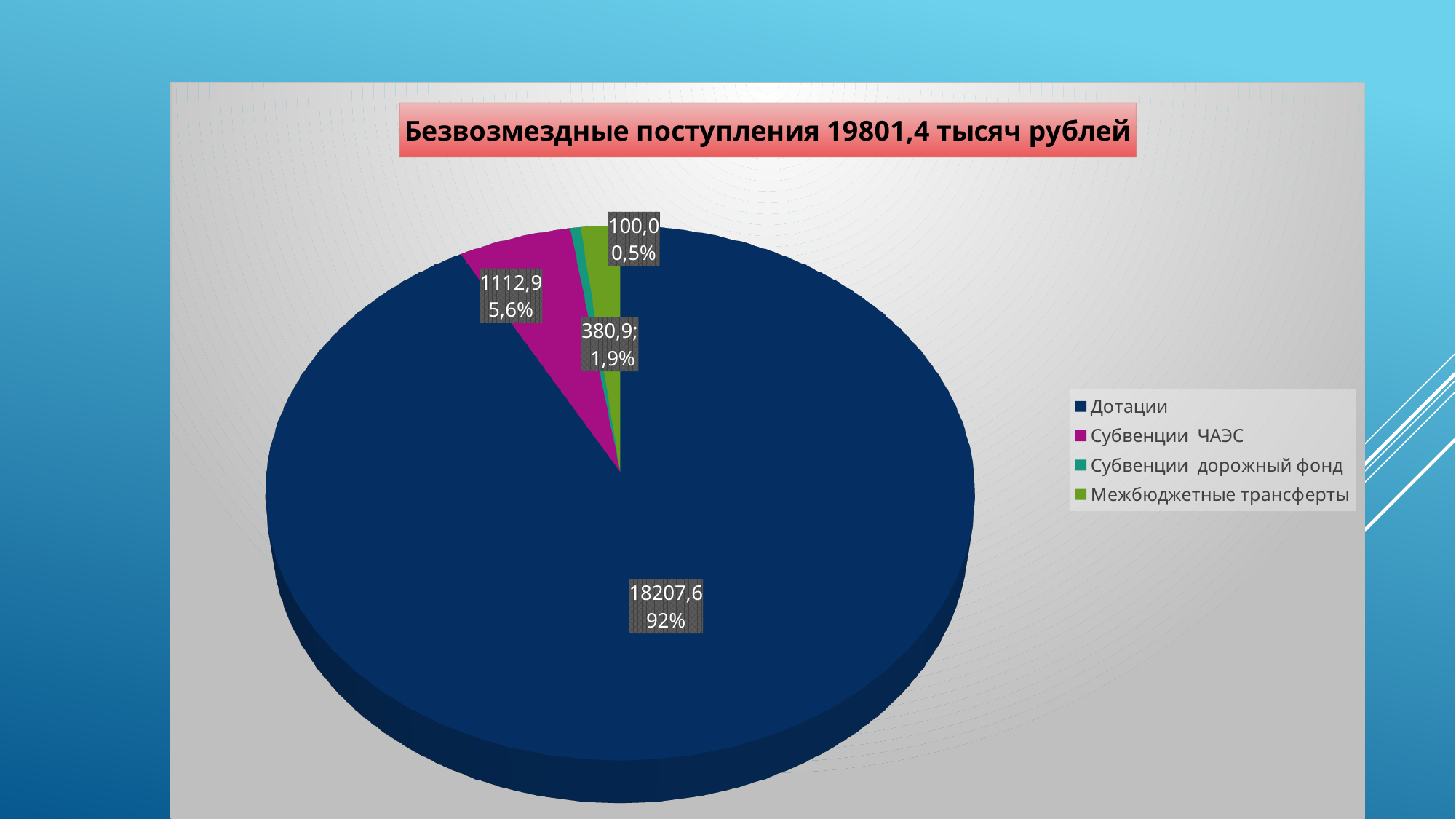
What kind of chart is shown on the slide? pie chart What is the value shown for Субвенции ЧАЭС? 1112,9 Which is larger, the slice for Субвенции ЧАЭС or the slice for Межбюджетные трансферты? Субвенции ЧАЭС How many slices does the pie chart have? 4 What is the value shown for Дотации? 18207,6 What share of the pie does Дотации represent? 92% How many entries does the legend list? 4 Which category has the largest slice? Дотации What is the difference between the values for Дотации and Субвенции ЧАЭС? 17094,7 What share of the pie does Субвенции ЧАЭС represent? 5,6% Which category has the smallest slice? Субвенции дорожный фонд What total amount is stated in the chart title? 19801,4 тысяч рублей